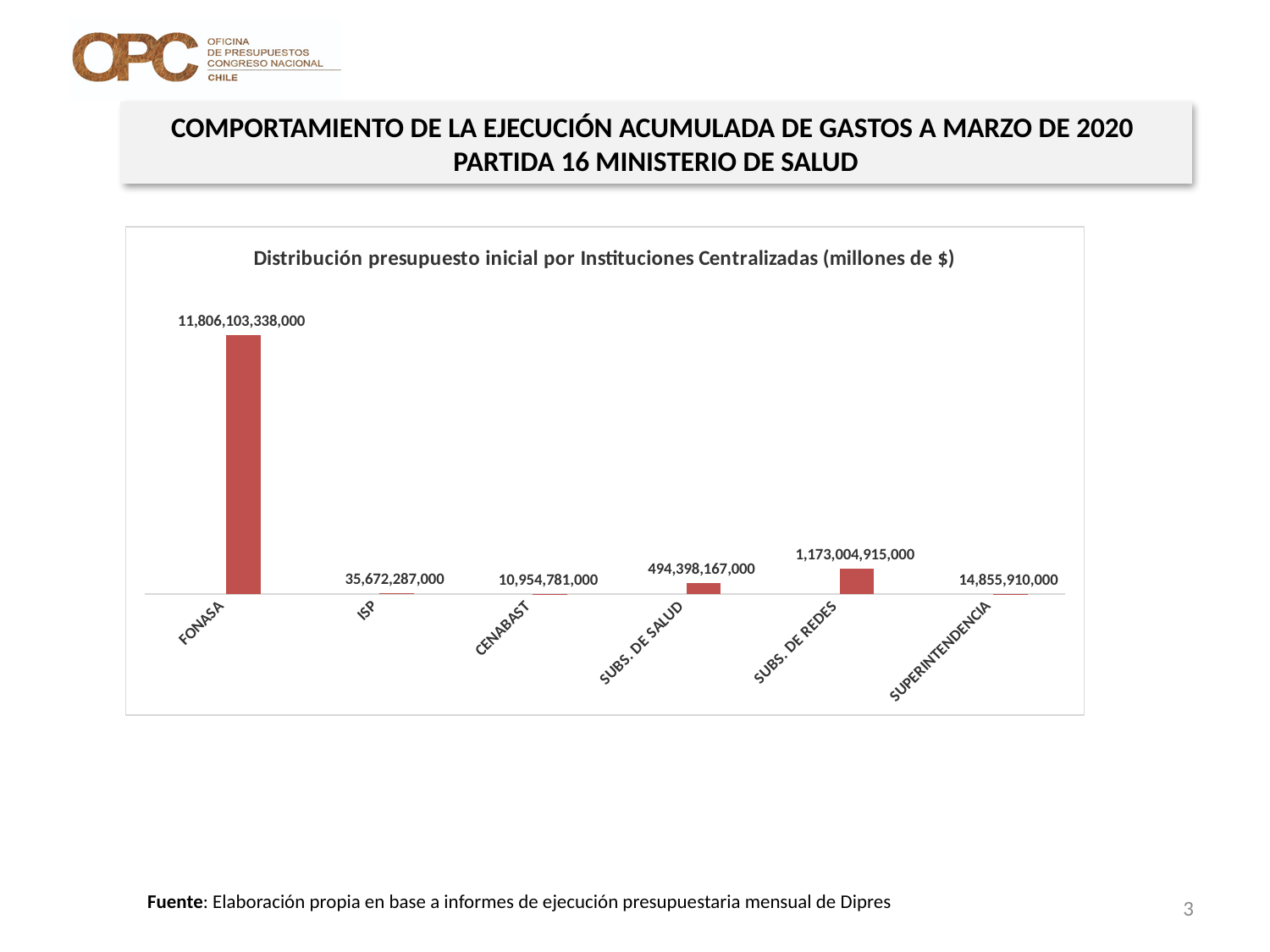
How many institutions are shown in the chart? 6 What is the value for FONASA in the chart? 11,806,103,338,000 What is the difference between the values for ISP and CENABAST? 24,717,506,000 What is the value for SUPERINTENDENCIA in the chart? 14,855,910,000 What kind of chart is shown on the slide? Bar chart What is the value for SUBS. DE REDES in the chart? 1,173,004,915,000 Which institution has the highest value in the chart? FONASA What is the title of the chart? Distribución presupuesto inicial por Instituciones Centralizadas (millones de $) What is the difference between the values for SUBS. DE REDES and SUBS. DE SALUD? 678,606,748,000 Which institution has the lowest value in the chart? CENABAST What is the value for CENABAST in the chart? 10,954,781,000 Which is larger, the value for SUBS. DE SALUD or the value for ISP? SUBS. DE SALUD